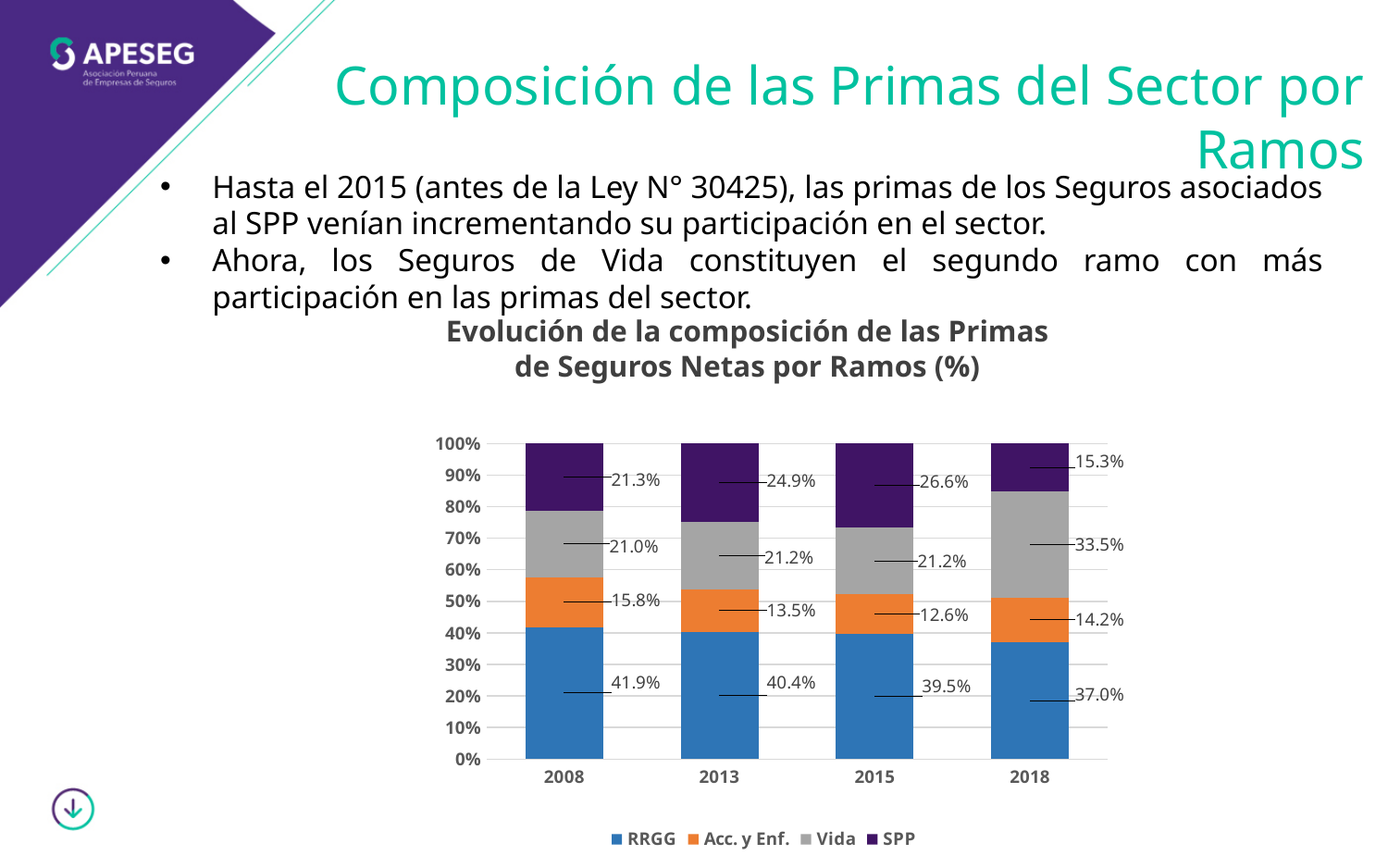
Which is larger in 2018, the Vida share or the SPP share? Vida In which year is the RRGG share lowest? 2018 What is the value for RRGG in 2008? 41.9% In which year is the SPP share highest? 2015 What is the value for Acc. y Enf. in 2013? 13.5% What is the value for SPP in 2015? 26.6% What is the value for Vida in 2018? 33.5% Does the RRGG share rise or fall from 2008 to 2018? Fall How many series does the legend list? 4 What type of chart is shown on the slide? Stacked bar chart What is the difference between the Vida share in 2018 and in 2015? 12.3% How many years are shown on the x axis? 4